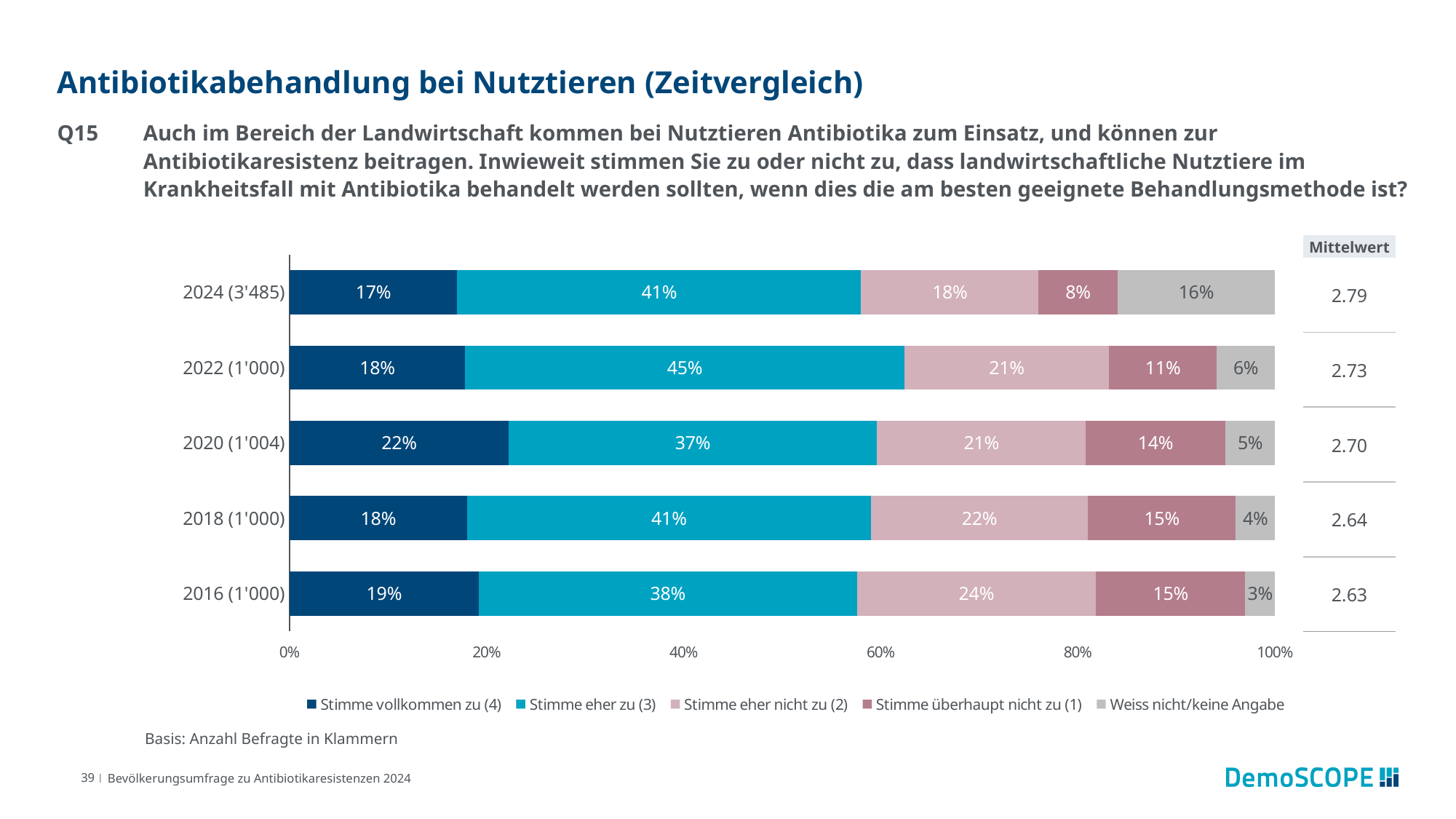
Which year has the highest "Stimme vollkommen zu (4)" share? 2020 (1'004) What is the difference between the "Stimme eher zu (3)" share in 2022 (1'000) and in 2020 (1'004)? 8 percentage points What is the "Weiss nicht/keine Angabe" share for 2022 (1'000)? 6% How many series does the legend list? 5 What is the combined share of "Stimme vollkommen zu (4)" and "Stimme eher zu (3)" in 2022 (1'000)? 63% How does the Mittelwert change from 2016 to 2024? It rises Which year has the lowest "Weiss nicht/keine Angabe" share? 2016 (1'000) Is the "Stimme überhaupt nicht zu (1)" share larger in 2018 (1'000) or in 2024 (3'485)? 2018 (1'000) How many years (bars) are shown in the chart? 5 What is the Mittelwert shown for 2020 (1'004)? 2.70 What kind of chart is shown on the slide? Stacked bar chart What percentage of respondents in 2024 (3'485) answered "Stimme eher zu (3)"? 41%